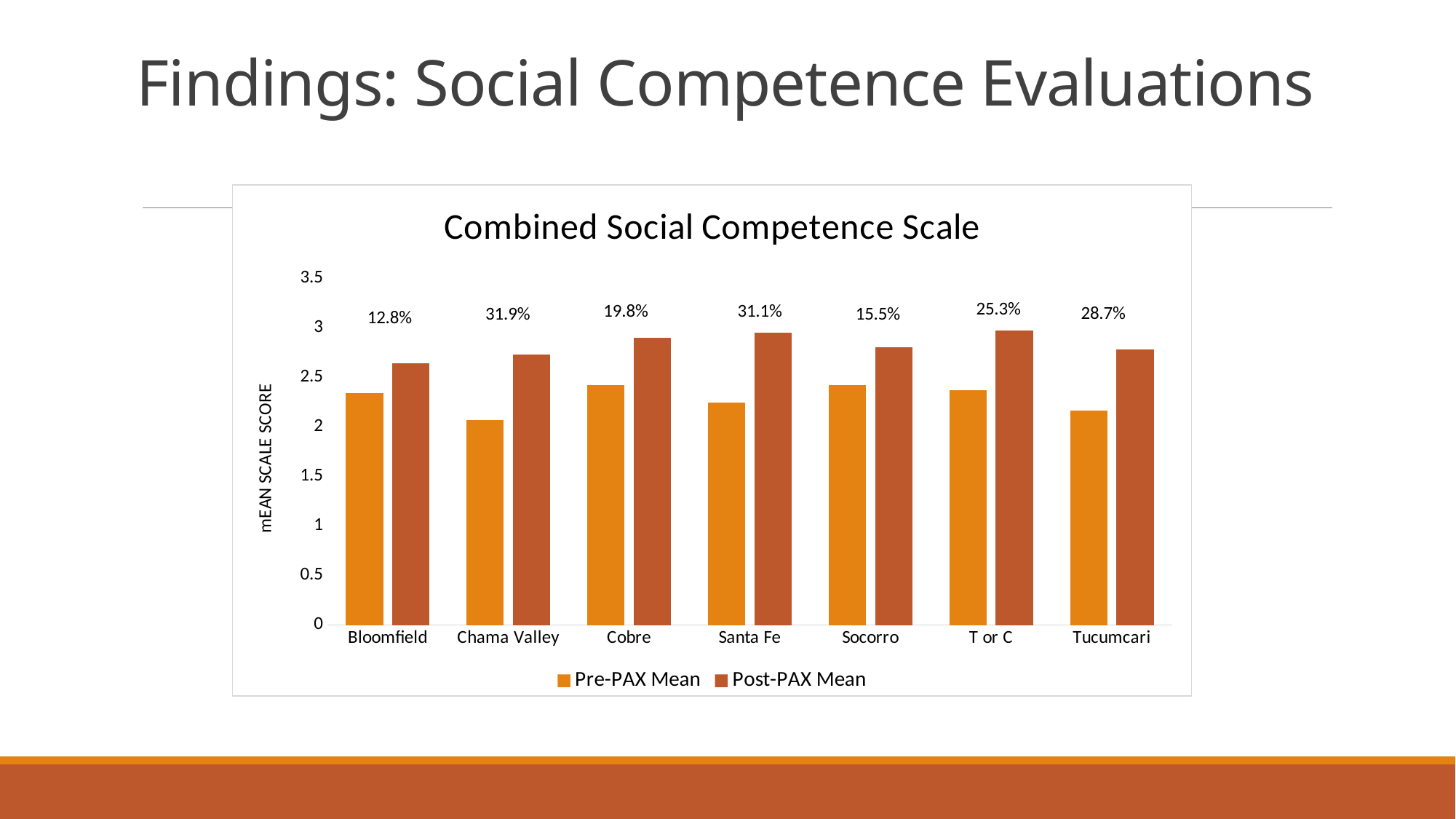
For Santa Fe, which is larger: the Pre-PAX Mean or the Post-PAX Mean? Post-PAX Mean What kind of chart is shown on the slide? bar chart What percentage label is shown above the bars for Socorro? 15.5% Is the Post-PAX Mean value for Socorro greater or less than 3? less How many series does the legend list? 2 Which site has the highest percentage label shown above its bars? Chama Valley What is the title of the chart? Combined Social Competence Scale What percentage label is shown above the bars for Chama Valley? 31.9% What percentage label is shown above the bars for Tucumcari? 28.7% Which site has the lowest percentage label shown above its bars? Bloomfield How many categories (sites) are shown on the x axis? 7 Is the Pre-PAX Mean value for Bloomfield greater or less than 2? greater